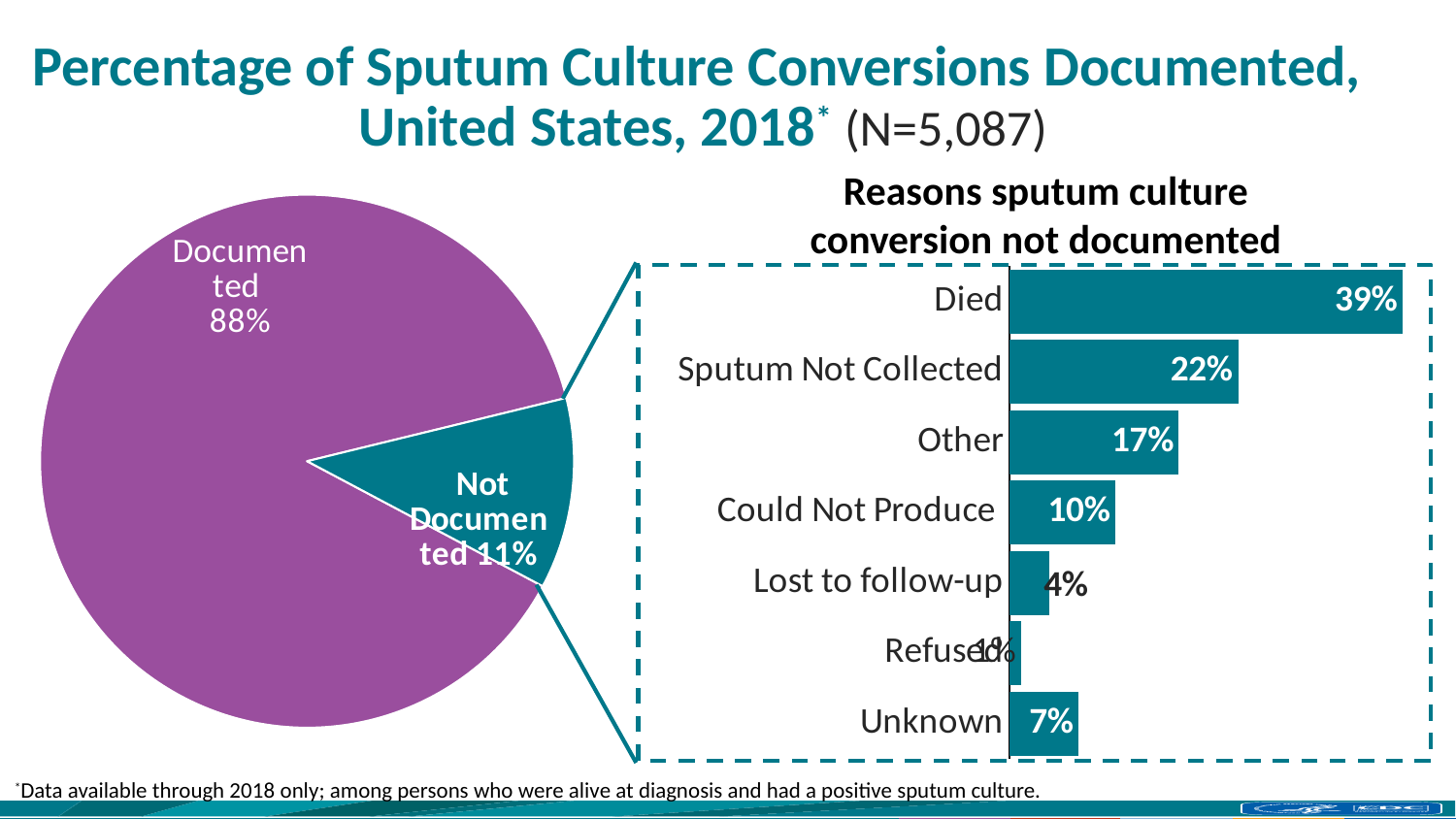
What kind of chart is the chart on the left of the slide? Pie chart On the 'Reasons sputum culture conversion not documented' chart, what is the value for Unknown? 7% On the 'Reasons sputum culture conversion not documented' chart, which is larger, Other or Could Not Produce? Other What kind of chart is the 'Reasons sputum culture conversion not documented' chart? Bar chart On the 'Reasons sputum culture conversion not documented' chart, which reason has the highest value? Died On the pie chart, what percentage of sputum culture conversions were not documented? 11% On the pie chart, what percentage of sputum culture conversions were documented? 88% On the 'Reasons sputum culture conversion not documented' chart, which reason has the lowest value? Refused On the 'Reasons sputum culture conversion not documented' chart, what is the difference between Died and Sputum Not Collected? 17% On the 'Reasons sputum culture conversion not documented' chart, what is the value for Died? 39% On the 'Reasons sputum culture conversion not documented' chart, what is the value for Sputum Not Collected? 22% On the 'Reasons sputum culture conversion not documented' chart, how many reasons are listed? 7